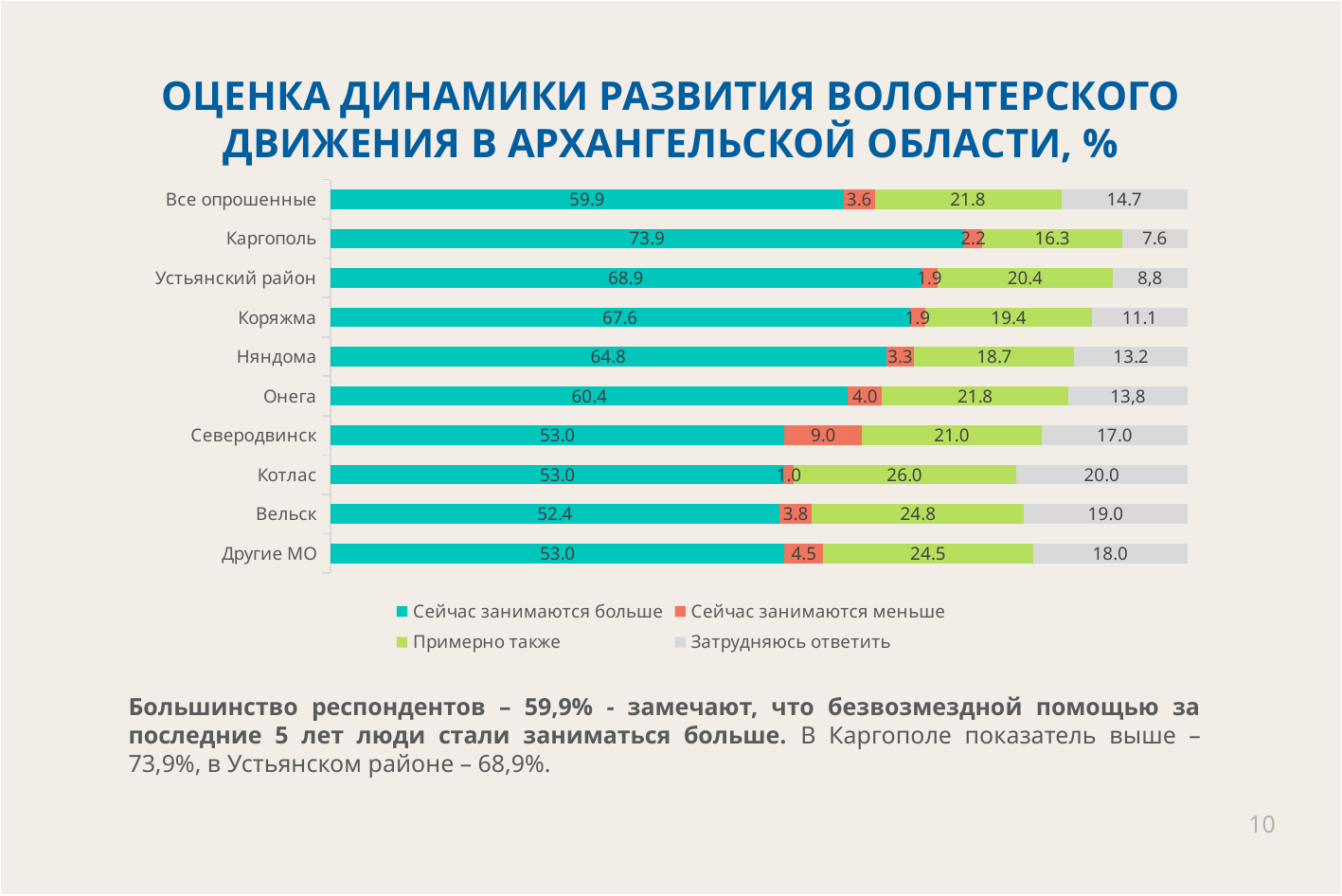
How many categories are shown on the chart? 10 Which has the larger «Примерно также» value, Котлас or Вельск? Котлас Which category has the lowest value for «Сейчас занимаются больше»? Вельск What is the value of «Затрудняюсь ответить» for Котлас? 20.0 How many series does the legend list? 4 What kind of chart is shown on the slide? Stacked bar chart Which category has the highest value for «Сейчас занимаются меньше»? Северодвинск How much higher is the «Сейчас занимаются больше» value for Каргополь than for Все опрошенные? 14.0 What is the value of «Примерно также» for Онега? 21.8 Which category has the highest value for «Сейчас занимаются больше»? Каргополь What is the total of the stacked bar for Все опрошенные? 100.0 What is the value of «Сейчас занимаются больше» for Каргополь? 73.9